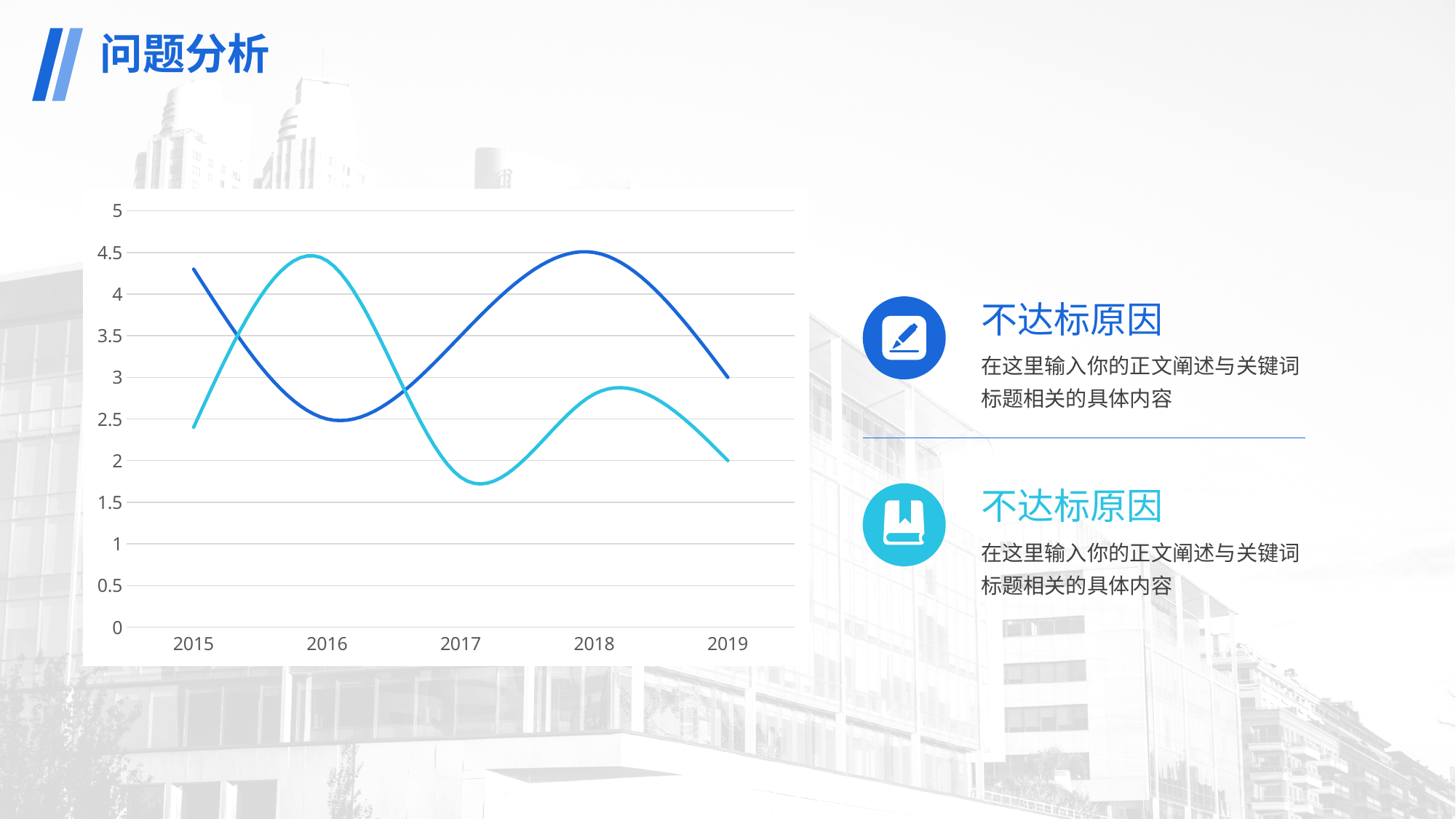
Is the value of the light blue line in 2017 greater or less than 2? less Is the value of the dark blue line in 2015 greater or less than 4? greater In 2016, which line is higher, the dark blue line or the light blue line? light blue line In which year does the light blue line reach its highest value? 2016 What is the value of the dark blue line in 2019? 3 What is the value of the light blue line in 2019? 2 In 2018, which line is higher, the dark blue line or the light blue line? dark blue line In which year does the dark blue line reach its lowest value? 2016 How many years are shown on the x axis of the chart? 5 Does the dark blue line rise or fall from 2016 to 2018? rise What kind of chart is shown on the slide? line chart In which year does the light blue line reach its lowest value? 2017